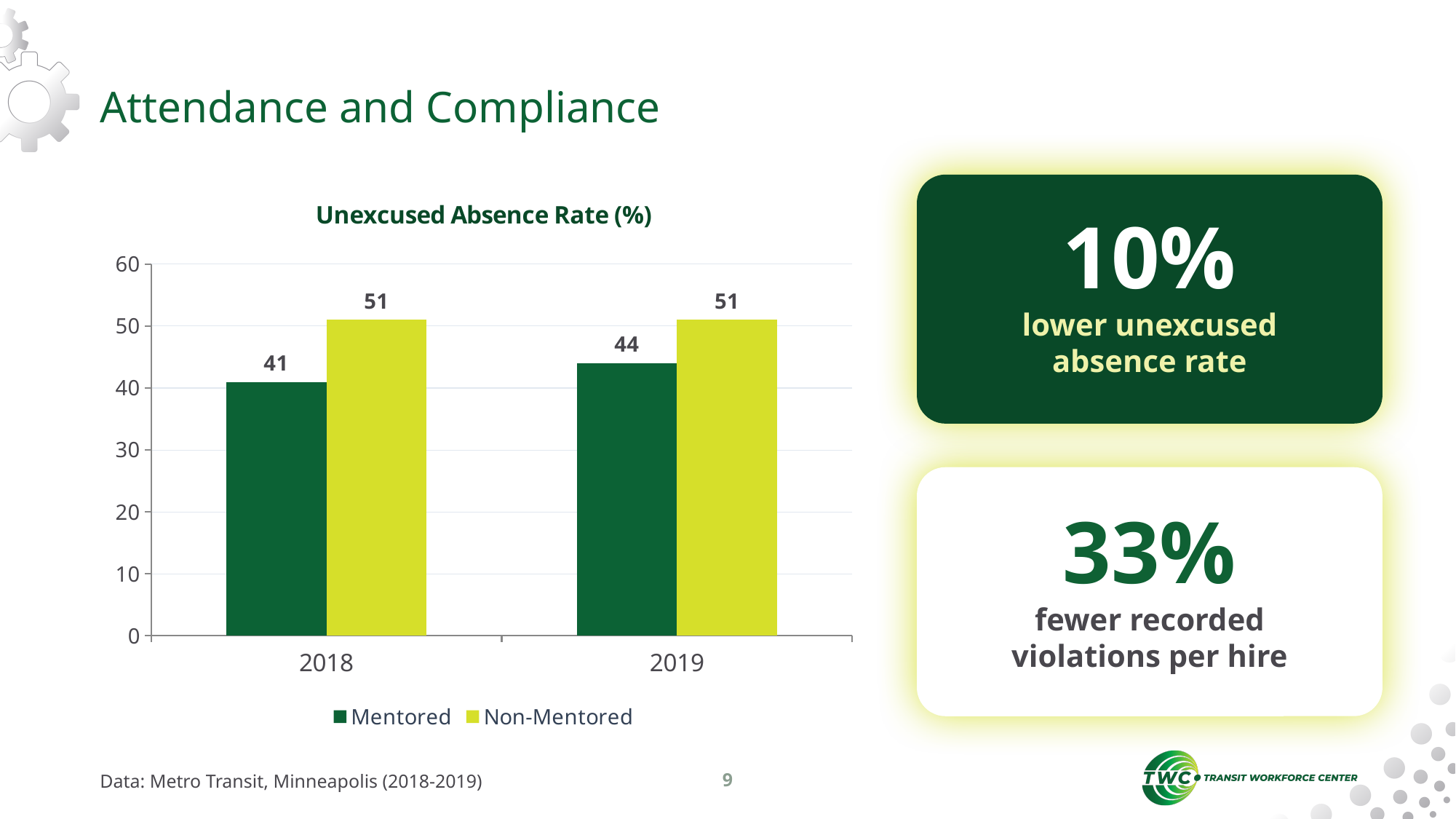
How many series does the legend list? 2 Is the Mentored value for 2019 greater or less than 50? less What kind of chart is shown? bar chart What is the title of the chart? Unexcused Absence Rate (%) What is the difference between the Non-Mentored and Mentored values in 2019? 7 How many years are shown on the x axis? 2 Which series has the lowest value in 2018? Mentored What is the unexcused absence rate for Mentored in 2019? 44 What is the difference between the Non-Mentored and Mentored values in 2018? 10 Which is larger, the Mentored value in 2018 or the Mentored value in 2019? 2019 What is the unexcused absence rate for Mentored in 2018? 41 What is the unexcused absence rate for Non-Mentored in 2019? 51